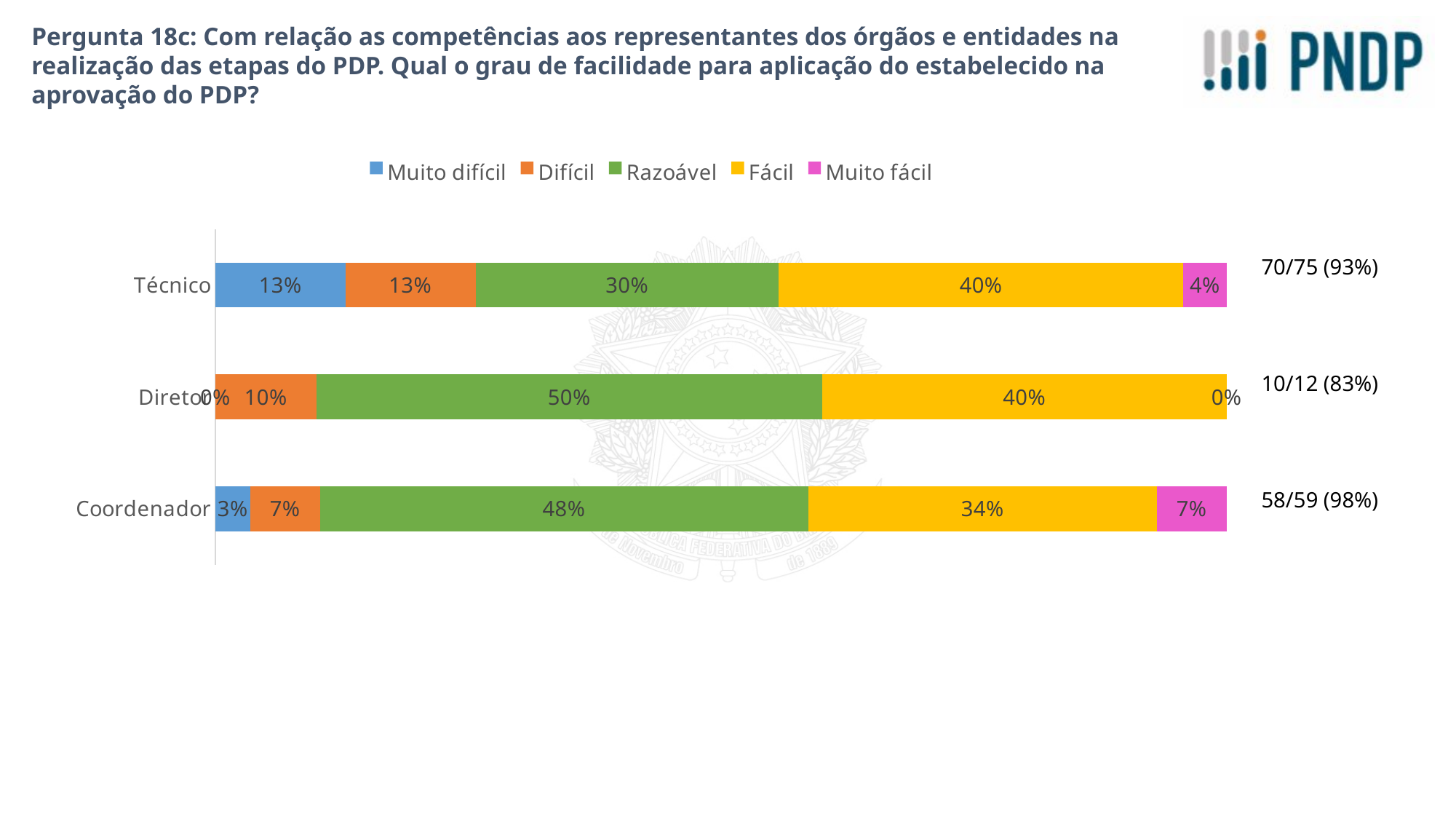
What is the Muito difícil value for Técnico? 13% What response count annotation is shown next to the Técnico bar? 70/75 (93%) What is the Muito fácil value for Coordenador? 7% What is the Fácil value for Coordenador? 34% Which category has the lowest Fácil value? Coordenador What is the difference between the Razoável values for Coordenador and Técnico? 18% How many categories are plotted on the chart? 3 Which category has the highest Razoável value? Diretor How many series does the legend list? 5 What is the Razoável value for Diretor? 50% What kind of chart is shown on the slide? Stacked bar chart Which is larger, the Difícil value for Técnico or for Diretor? Técnico